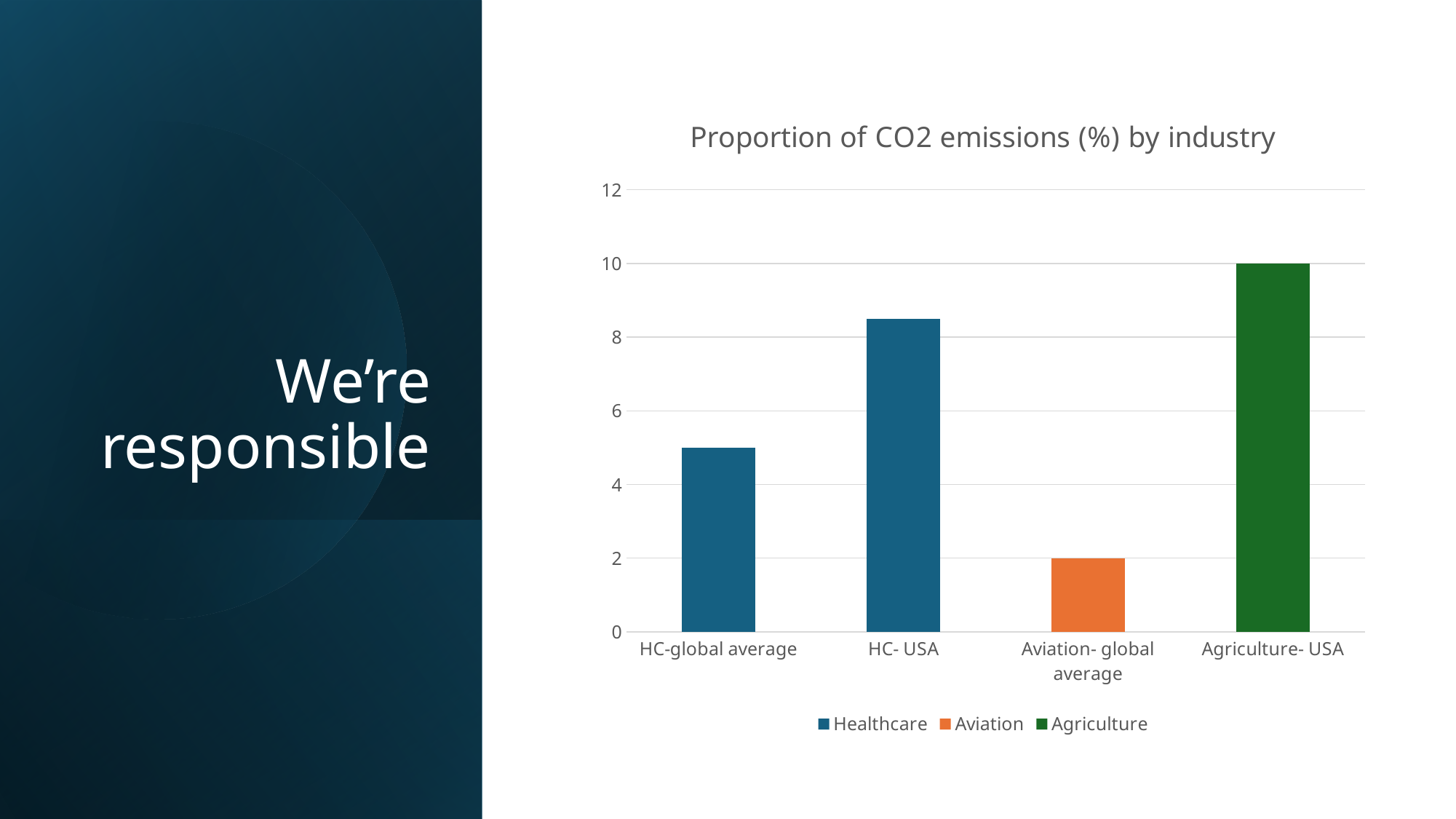
What is the value for Aviation- global average? 2 What type of chart is shown on the slide? bar chart Which category has the lowest value in the chart? Aviation- global average How many categories are shown on the x axis of the chart? 4 Is the value for HC- USA greater or less than 10? less What is the value for Agriculture- USA? 10 Which is larger, the value for HC- USA or the value for HC-global average? HC- USA What is the title of the chart? Proportion of CO2 emissions (%) by industry How many series does the legend list? 3 What is the difference between the values for Agriculture- USA and Aviation- global average? 8 Which category has the highest value in the chart? Agriculture- USA Is the value for HC-global average greater or less than 4? greater